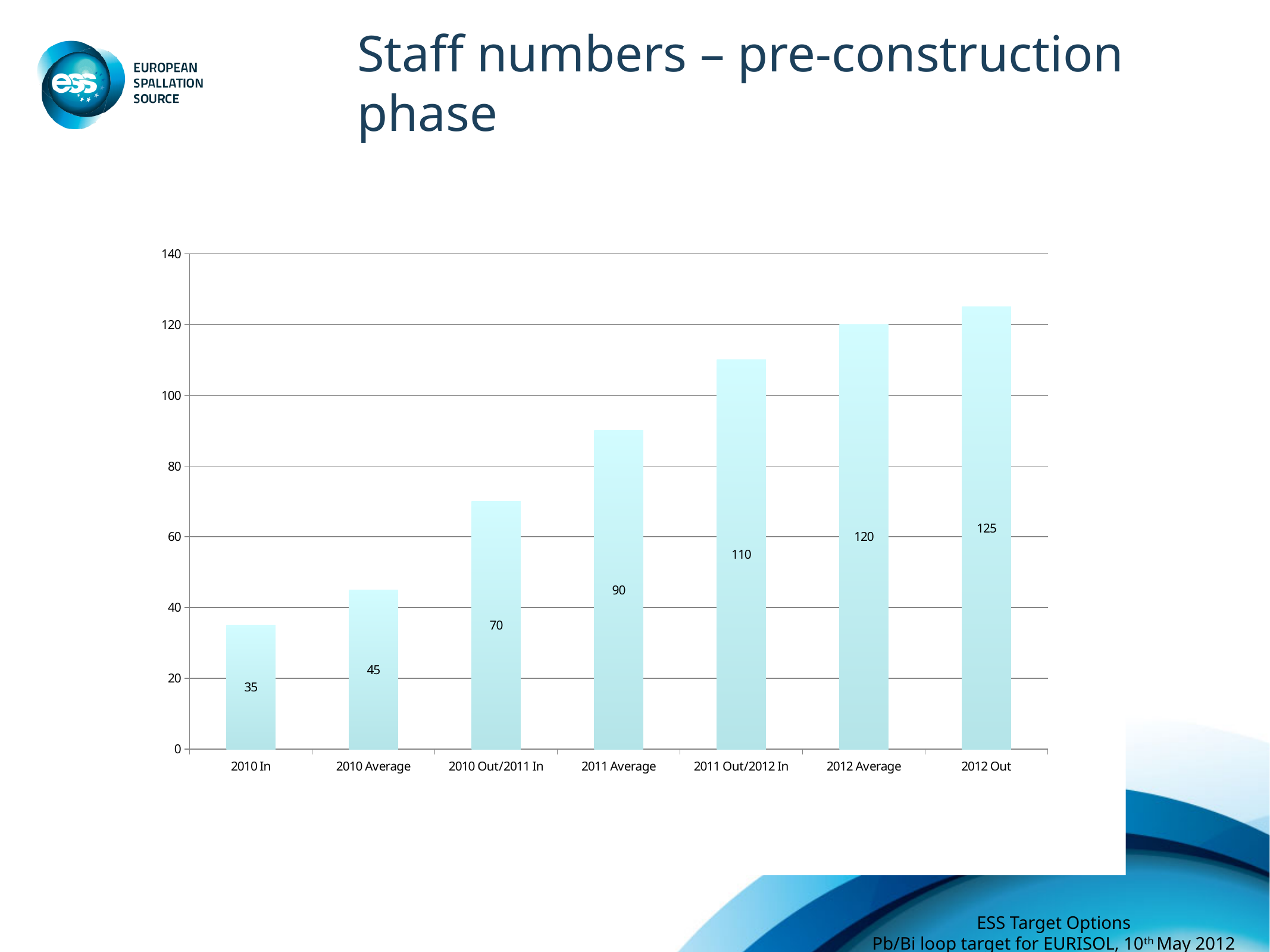
What kind of chart is shown on the slide? bar chart Do the values rise or fall from left to right along the x axis? rise What is the value for 2010 In? 35 What is the difference between the values for 2012 Average and 2010 Average? 75 What is the value for 2011 Average? 90 How many categories are shown on the x axis? 7 Which category has the lowest value? 2010 In What is the value for 2010 Out/2011 In? 70 Which is larger, the value for 2011 Out/2012 In or the value for 2011 Average? 2011 Out/2012 In Which category has the highest value? 2012 Out What is the value for 2012 Out? 125 Is the value for 2011 Out/2012 In greater or less than 100? greater